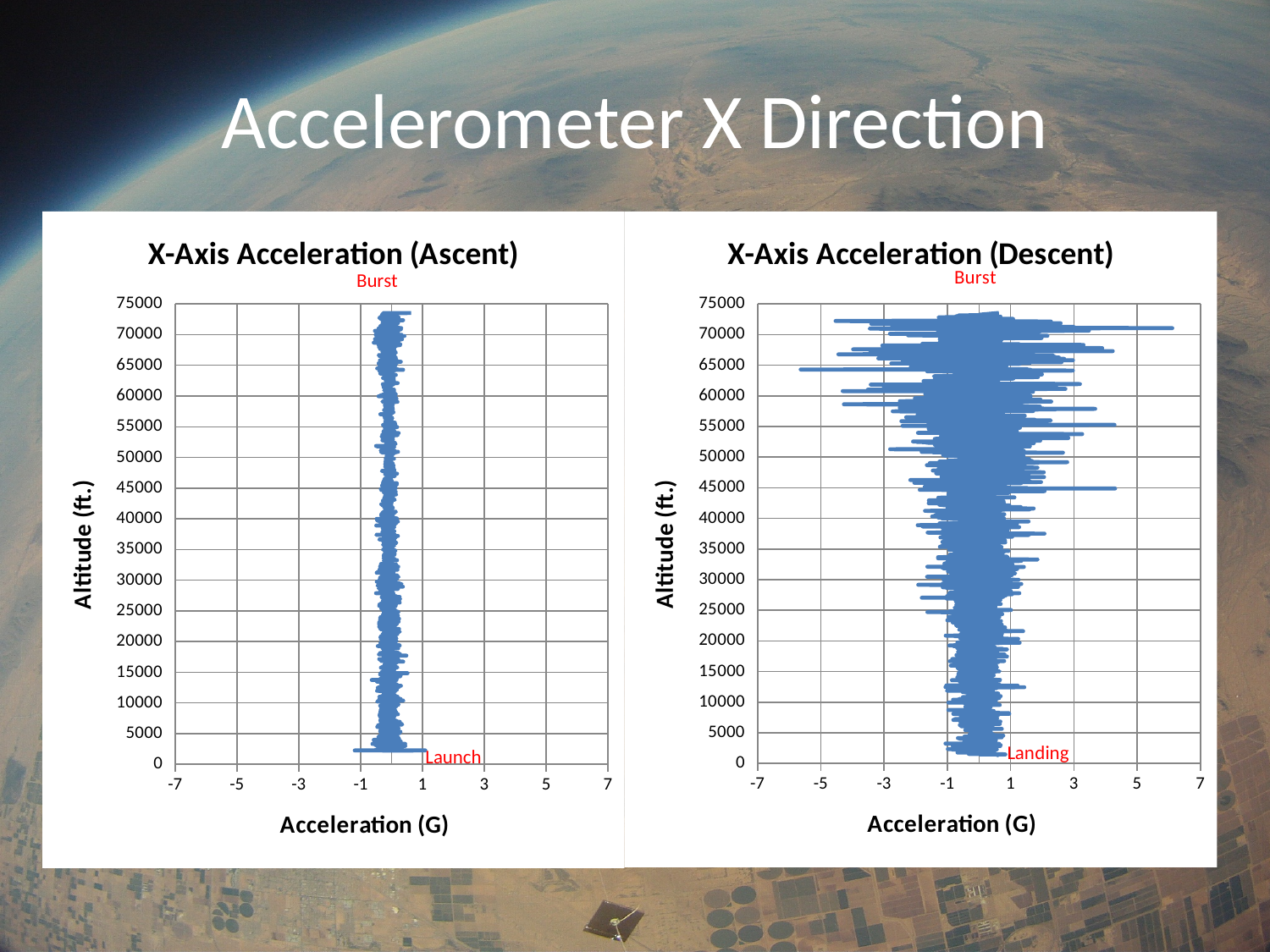
Which chart shows a wider spread of acceleration values, X-Axis Acceleration (Ascent) or X-Axis Acceleration (Descent)? X-Axis Acceleration (Descent) In the X-Axis Acceleration (Ascent) chart, what is the highest altitude tick shown on the vertical axis? 75000 In the X-Axis Acceleration (Descent) chart, what are the minimum and maximum values shown on the horizontal axis? -7 and 7 In the X-Axis Acceleration (Descent) chart, what annotation is written in red near the bottom of the data at 0 altitude? Landing What is the title of the chart on the left side of the slide? X-Axis Acceleration (Ascent) In the X-Axis Acceleration (Descent) chart, is the largest acceleration value reached greater or less than 5? greater In the X-Axis Acceleration (Ascent) chart, is the largest acceleration value reached greater or less than 3? less In the X-Axis Acceleration (Ascent) chart, what is the label of the vertical axis? Altitude (ft.) What is the title of the chart on the right side of the slide? X-Axis Acceleration (Descent) In the X-Axis Acceleration (Descent) chart, is the most negative acceleration value reached greater or less than -5? less What kind of chart is the X-Axis Acceleration (Ascent) chart? Line chart In the X-Axis Acceleration (Descent) chart, what is the label of the horizontal axis? Acceleration (G)